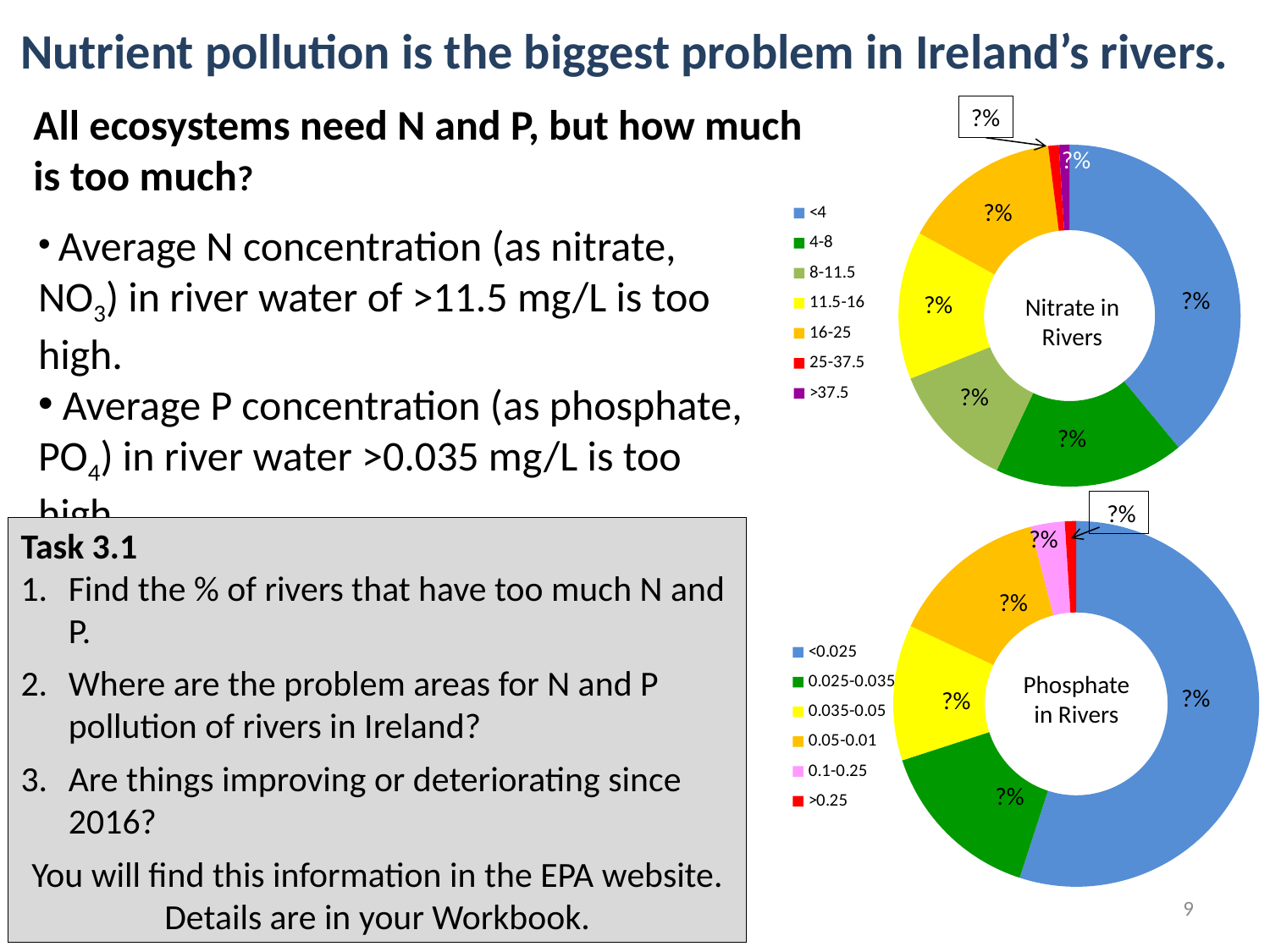
What colour is the '<4' slice in the 'Nitrate in Rivers' chart? blue How many categories does the legend of the 'Phosphate in Rivers' chart list? 6 In the 'Phosphate in Rivers' chart, which category has the largest slice? <0.025 In the 'Phosphate in Rivers' chart, which category has the smallest slice? >0.25 What is the title shown in the centre of the lower chart? Phosphate in Rivers In the 'Nitrate in Rivers' chart, which slice is larger: '16-25' or '25-37.5'? 16-25 In the 'Nitrate in Rivers' chart, which slice is larger: '<4' or '4-8'? <4 In the 'Phosphate in Rivers' chart, which slice is larger: '<0.025' or '0.035-0.05'? <0.025 What kind of chart is the 'Nitrate in Rivers' chart? doughnut chart In the 'Nitrate in Rivers' chart, which category has the largest slice? <4 How many categories does the legend of the 'Nitrate in Rivers' chart list? 7